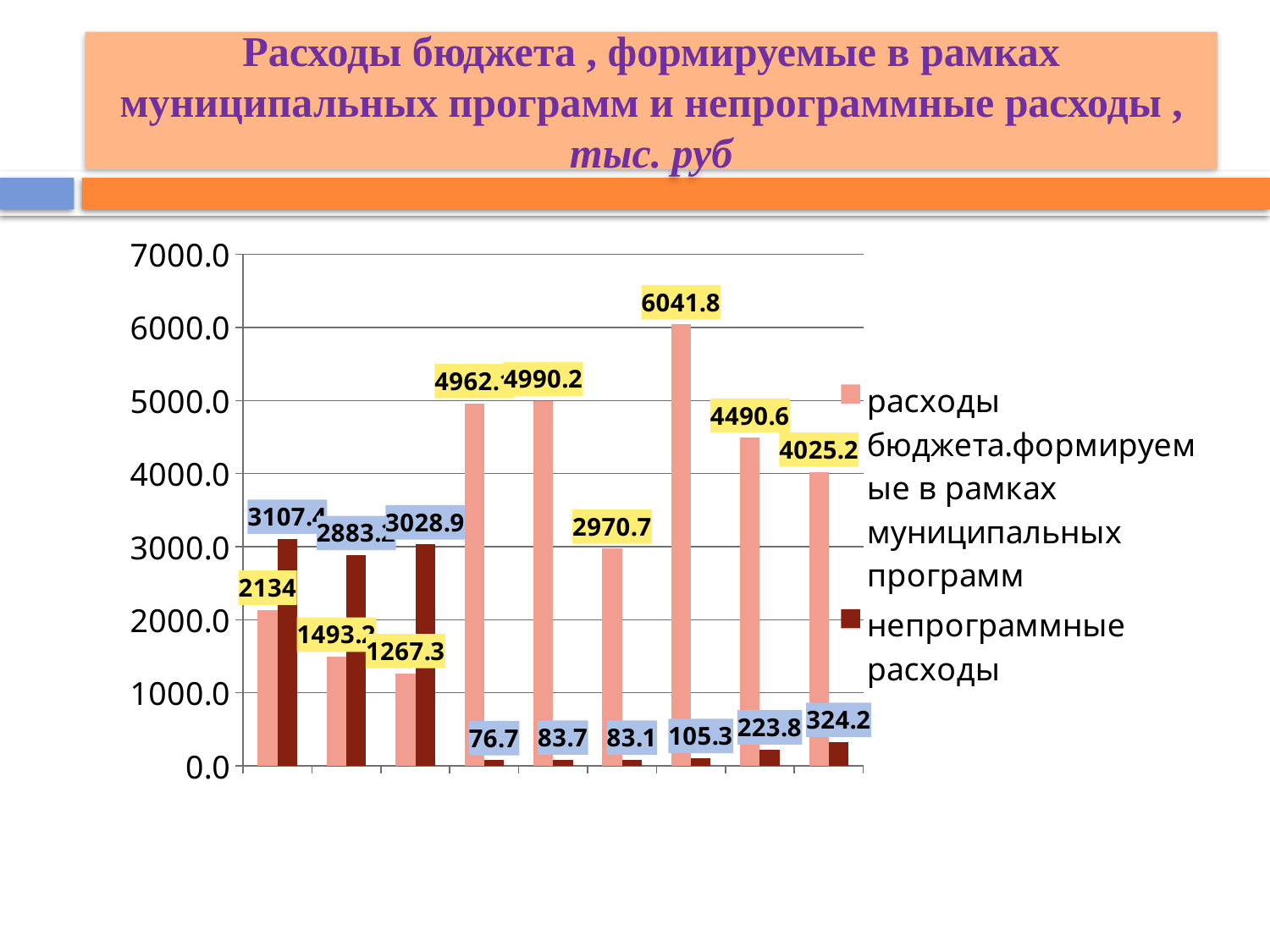
How many series does the legend list? 2 Is the tallest bar on the chart greater or less than 6000? greater What is the value of 'непрограммные расходы' in the rightmost group of bars? 324.2 What unit is stated in the chart title? тыс. руб What is the highest value shown for the series 'расходы бюджета, формируемые в рамках муниципальных программ'? 6041.8 How many groups of bars are plotted along the x axis? 9 Which is larger: the 'расходы бюджета, формируемые в рамках муниципальных программ' value of 4990.2 or 4490.6? 4990.2 What kind of chart is shown on the slide? bar chart What is the lowest value shown for the series 'расходы бюджета, формируемые в рамках муниципальных программ'? 1267.3 What is the lowest value shown for the series 'непрограммные расходы'? 76.7 What is the value of 'расходы бюджета, формируемые в рамках муниципальных программ' in the seventh group of bars from the left? 6041.8 What is the difference between the two highest values of 'расходы бюджета, формируемые в рамках муниципальных программ', 6041.8 and 4990.2? 1051.6